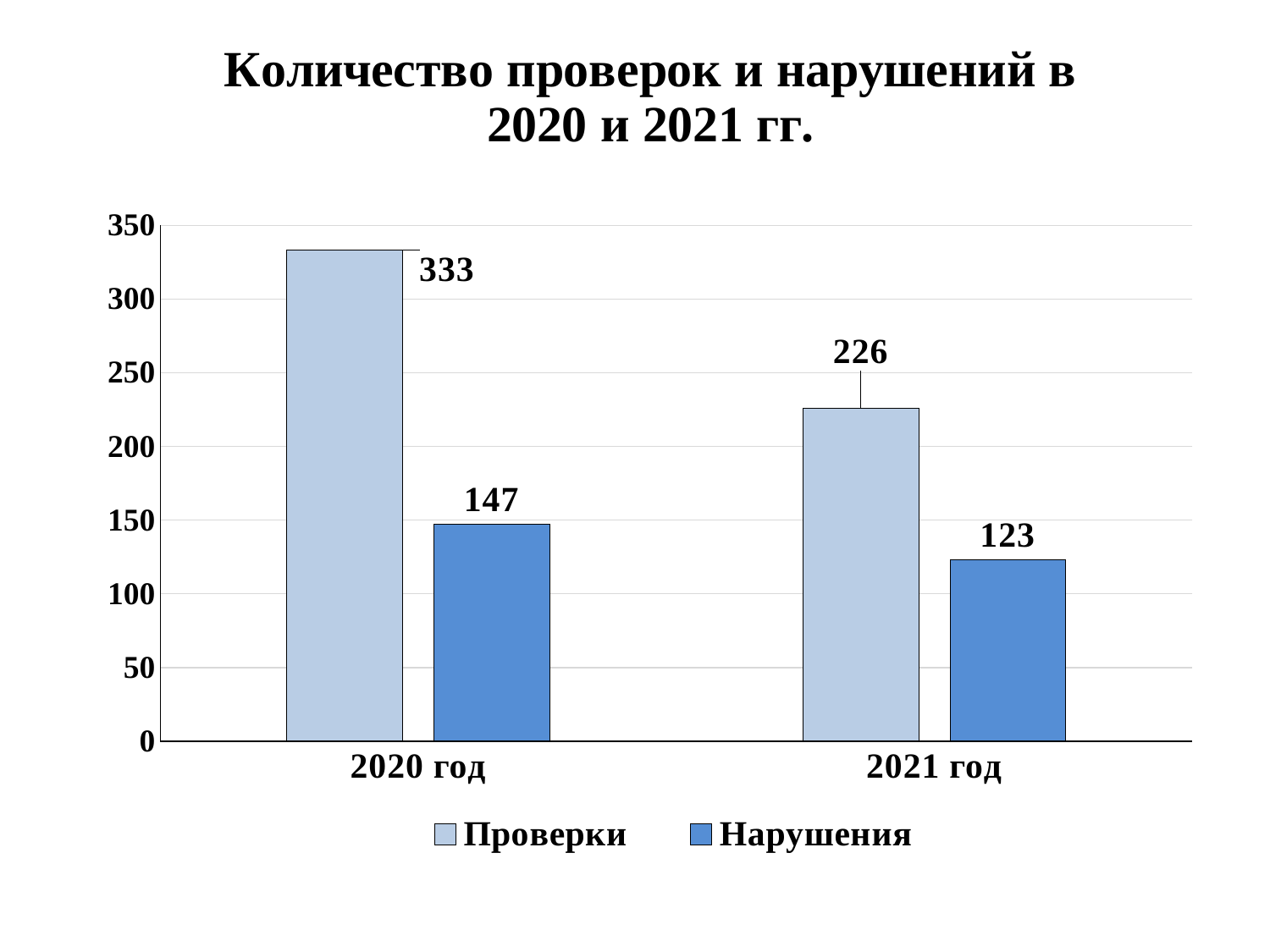
What is the value of Нарушения for 2020 год? 147 Which is larger: Нарушения in 2020 год or Нарушения in 2021 год? Нарушения in 2020 год What is the value of Нарушения for 2021 год? 123 What is the value of Проверки for 2020 год? 333 Do the values for Проверки rise or fall from 2020 год to 2021 год? Fall Which year has the lowest value for Нарушения? 2021 год What is the value of Проверки for 2021 год? 226 What kind of chart is shown on the slide? Bar chart Which year has the highest value for Проверки? 2020 год What is the difference between Проверки and Нарушения in 2021 год? 103 How many series does the legend list? 2 What is the difference between Проверки in 2020 год and Проверки in 2021 год? 107